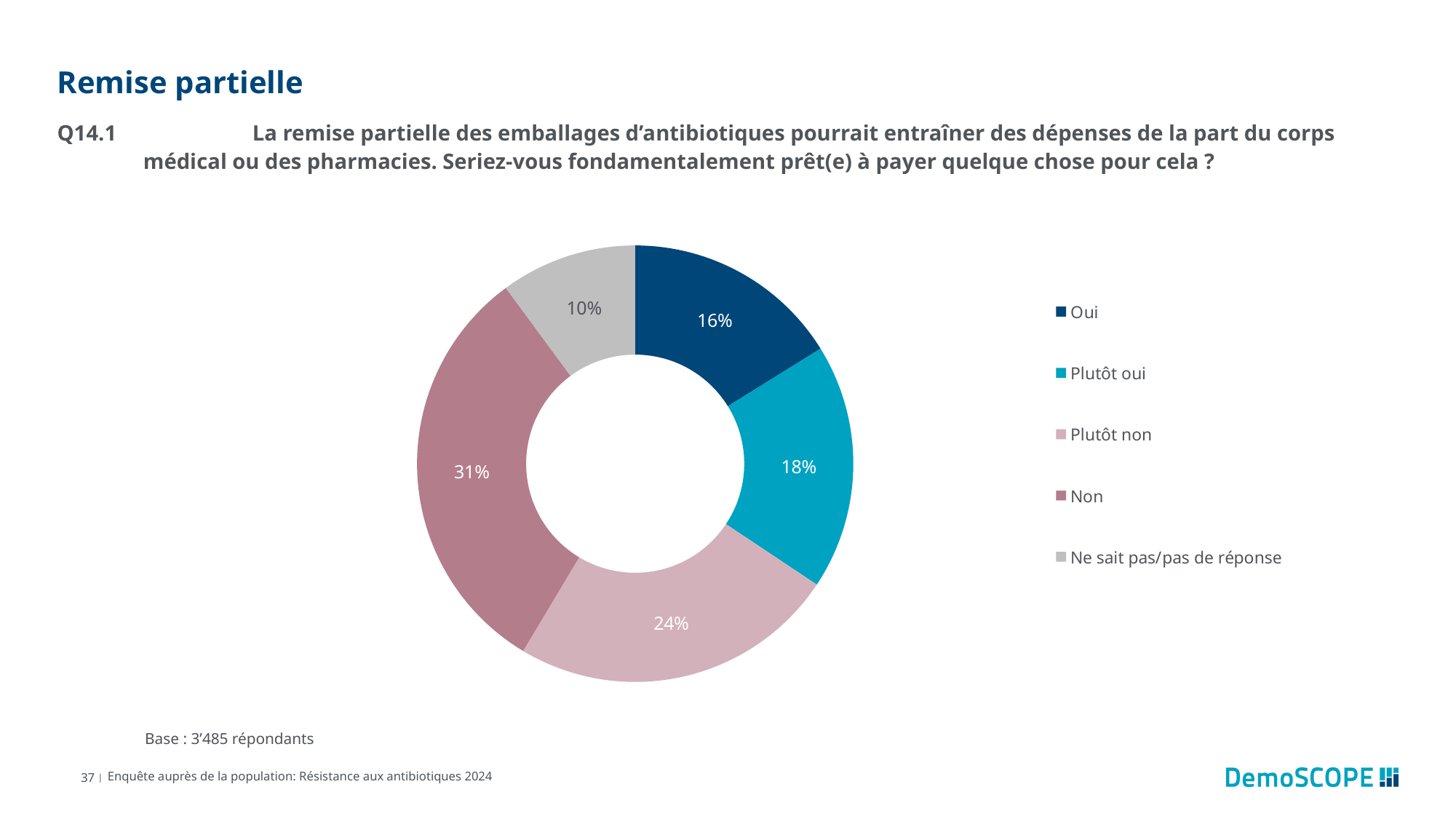
What percentage of respondents answered "Ne sait pas/pas de réponse"? 10% Which response category has the smallest share? Ne sait pas/pas de réponse Which is larger, the share for "Plutôt non" or the share for "Plutôt oui"? Plutôt non What type of chart is shown on the slide? Pie chart (donut) How many response categories are shown in the chart? 5 What percentage of respondents answered "Plutôt non"? 24% What percentage of respondents answered "Plutôt oui"? 18% What is the combined share of "Oui" and "Plutôt oui"? 34% What is the difference in percentage points between "Non" and "Oui"? 15 What percentage of respondents answered "Oui"? 16% What percentage of respondents answered "Non"? 31% Which response category has the largest share? Non